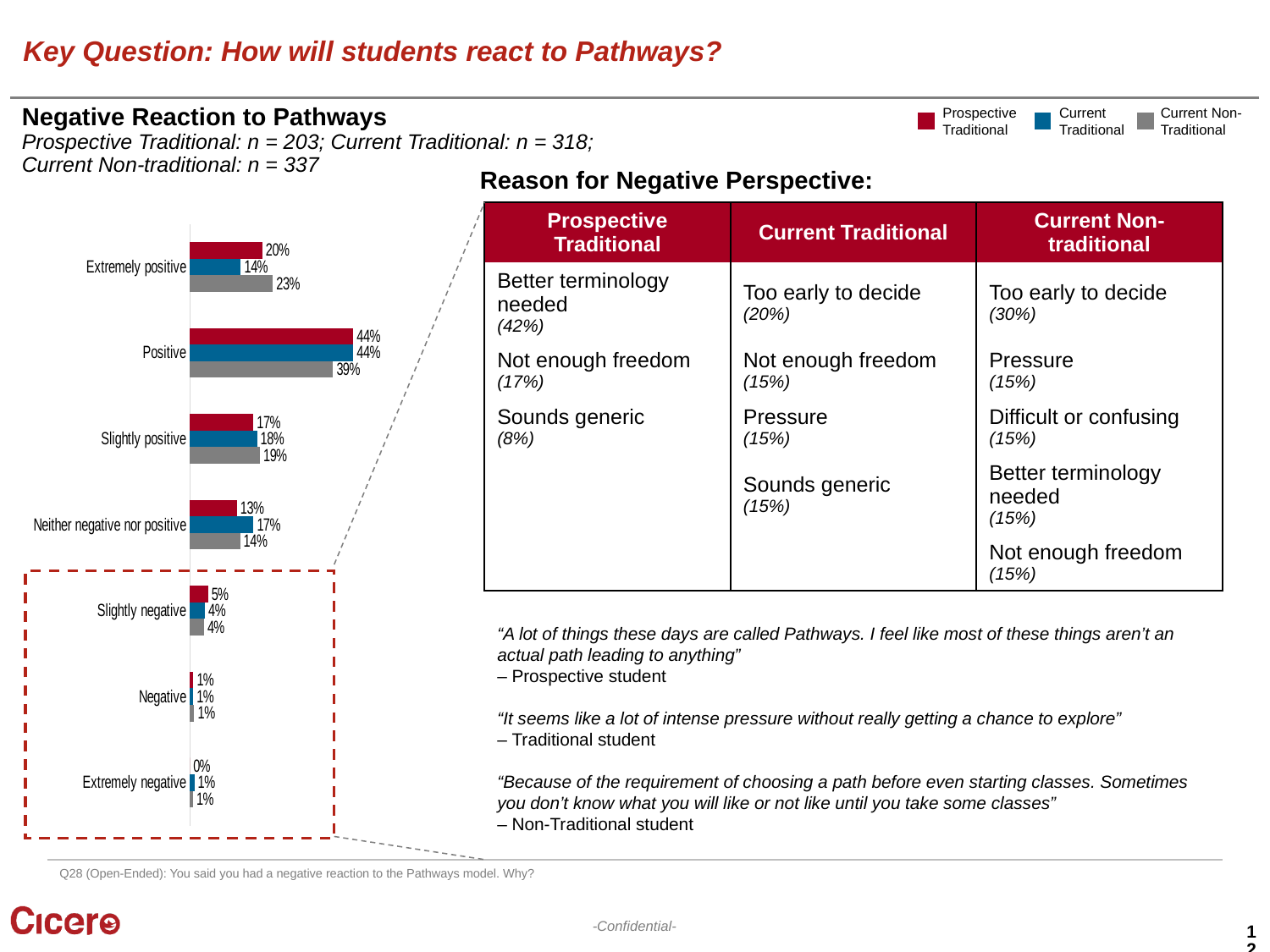
What kind of chart is shown on the slide? Bar chart For Positive, which is larger: the Current Traditional value or the Current Non-Traditional value? Current Traditional What is the Prospective Traditional value for Extremely negative? 0% Which series is shown in gray in the legend? Current Non-Traditional What is the Current Non-Traditional value for Extremely positive? 23% How many categories are shown on the chart? 7 Which category has the highest Prospective Traditional value? Positive What is the Current Traditional value for Neither negative nor positive? 17% What is the difference between the Prospective Traditional and Current Traditional values for Extremely positive? 6% How many series does the legend list? 3 Which category has the lowest Current Non-Traditional value? Negative and Extremely negative (1%) What is the Prospective Traditional value for Slightly negative? 5%